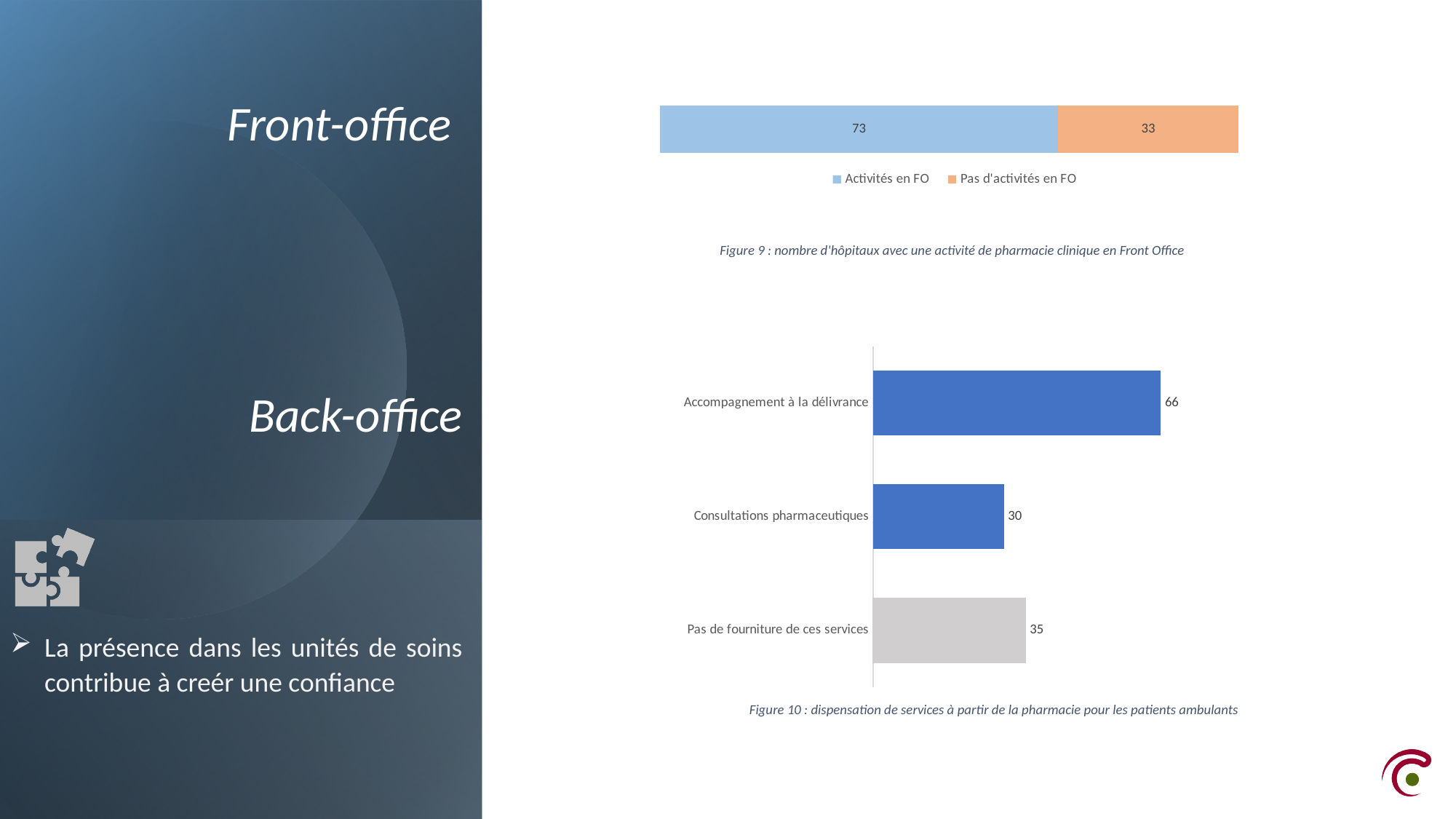
In the bottom chart (Figure 10), which category has the highest value? Accompagnement à la délivrance In the top chart (Figure 9), what is the difference between 'Activités en FO' and 'Pas d'activités en FO'? 40 In the top chart (Figure 9), what is the total of the stacked bar? 106 In the top chart (Figure 9), what is the value for 'Activités en FO'? 73 In the bottom chart (Figure 10), which category has the lowest value? Consultations pharmaceutiques In the top chart (Figure 9), what is the value for 'Pas d'activités en FO'? 33 In the top chart (Figure 9), how many series does the legend list? 2 In the bottom chart (Figure 10), what is the value for 'Consultations pharmaceutiques'? 30 In the bottom chart (Figure 10), what is the value for 'Pas de fourniture de ces services'? 35 In the bottom chart (Figure 10), what is the value for 'Accompagnement à la délivrance'? 66 In the bottom chart (Figure 10), what is the difference between 'Accompagnement à la délivrance' and 'Consultations pharmaceutiques'? 36 In the top chart (Figure 9), which series is larger, 'Activités en FO' or 'Pas d'activités en FO'? Activités en FO